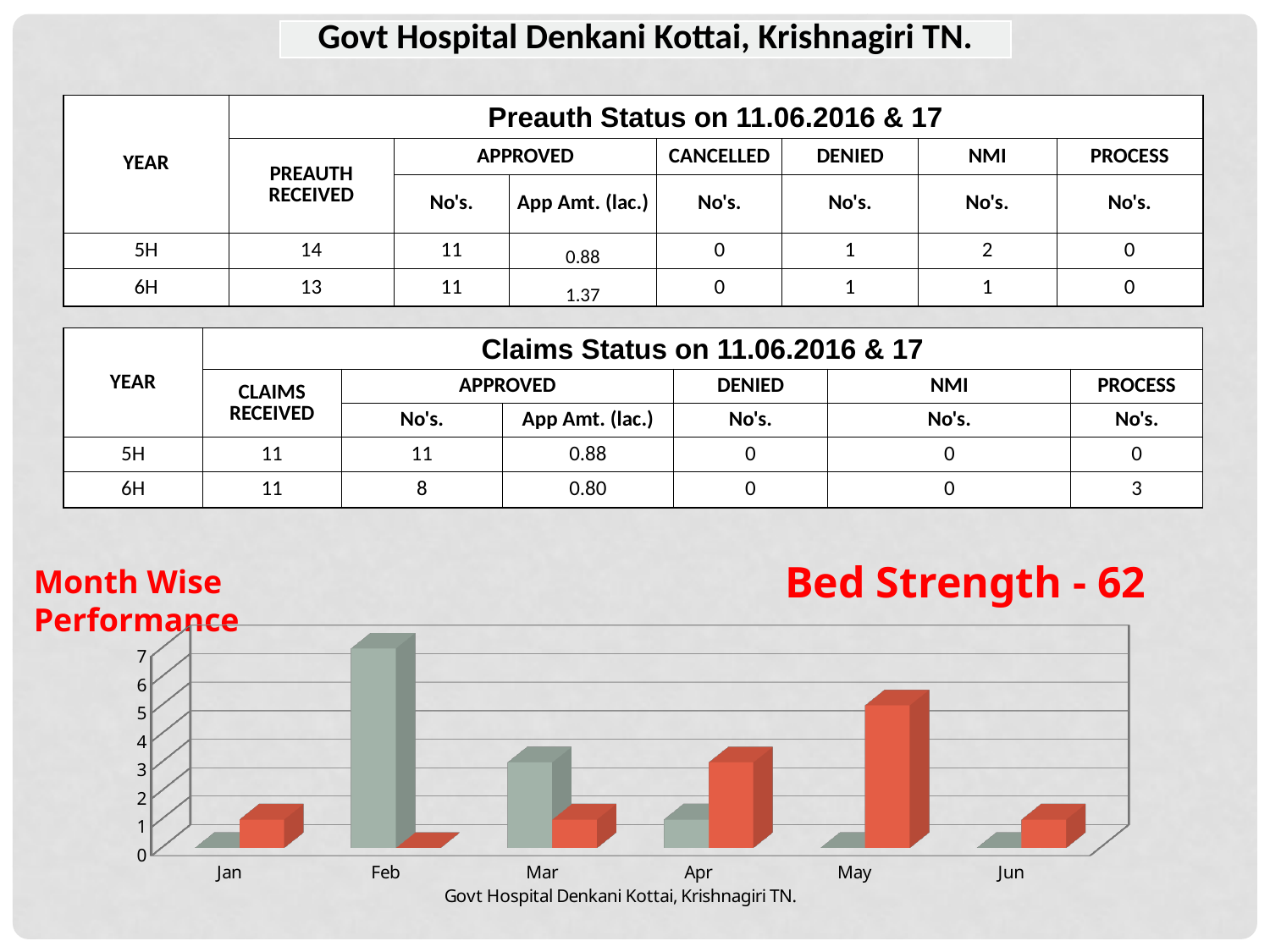
Is the red bar for May greater or less than 4? greater What text appears directly below the x axis of the bar chart? Govt Hospital Denkani Kottai, Krishnagiri TN. Which month has the tallest grey bar in the chart? Feb How many months are shown on the x axis of the bar chart? 6 Which is taller, the red bar for May or the red bar for Apr? May Is the grey bar for Feb greater or less than 5? greater What kind of chart is shown at the bottom of the slide? bar chart Which month has the tallest red bar in the chart? May Is the grey bar for Mar greater or less than 2? greater In Apr, which bar is taller, the grey bar or the red bar? the red bar In Mar, which bar is taller, the grey bar or the red bar? the grey bar